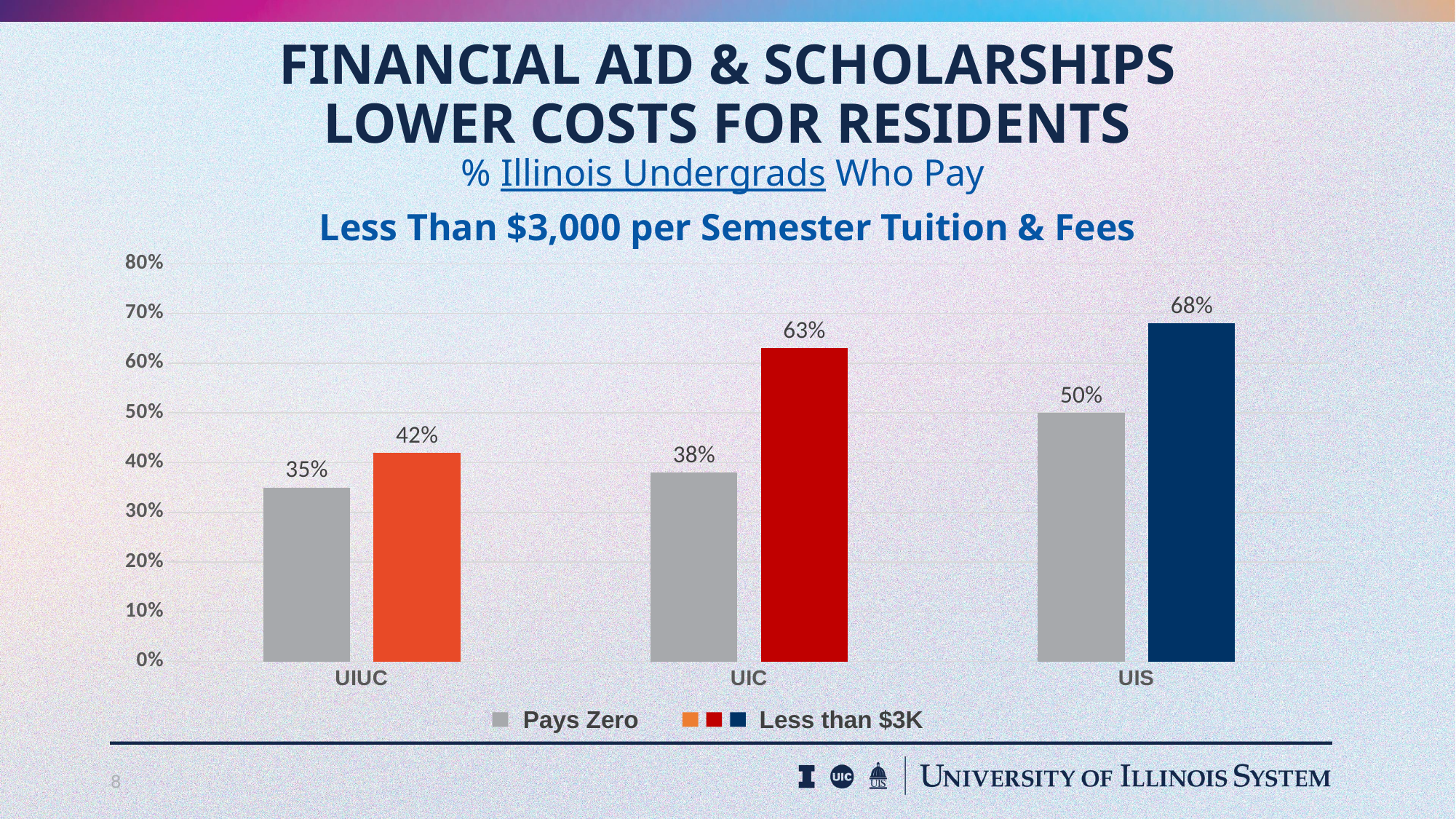
What percentage of UIC Illinois undergrads pay less than $3K? 63% Do the Less than $3K values rise or fall from UIUC to UIS? Rise What percentage of UIUC Illinois undergrads pay zero? 35% What is the difference between the Less than $3K and Pays Zero percentages for UIC? 25% What kind of chart is shown on the slide? Bar chart Which university has the highest percentage of undergrads paying less than $3K? UIS Which is larger: the Pays Zero percentage for UIS or the Less than $3K percentage for UIUC? Pays Zero for UIS How many universities are shown on the x axis? 3 Which university has the lowest percentage of undergrads paying zero? UIUC How many series does the legend list? 2 What is the difference between the Less than $3K percentages for UIS and UIUC? 26% What percentage of UIS Illinois undergrads pay zero? 50%